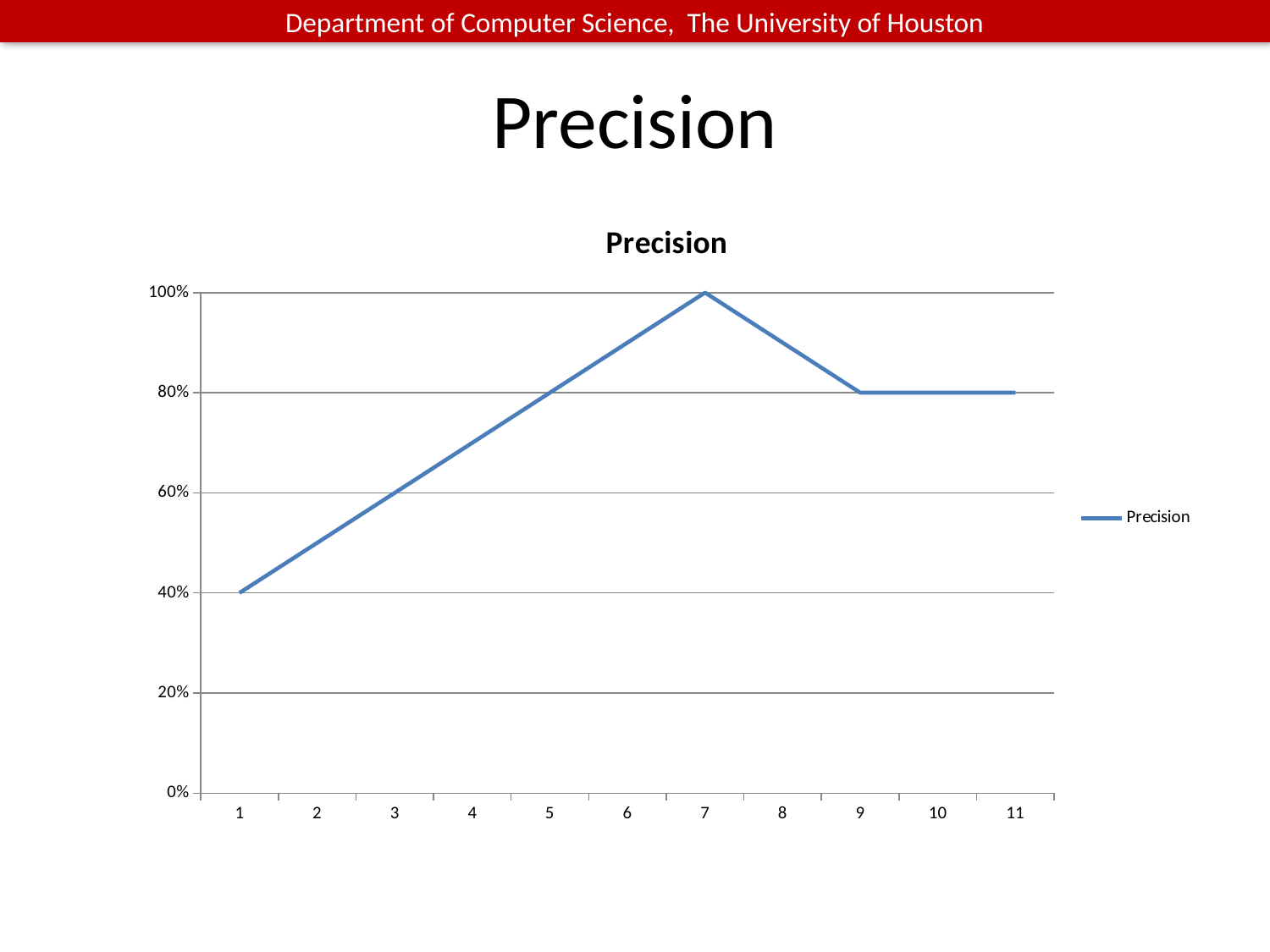
Does precision rise or fall from x = 1 to x = 7? rise At which x value is precision lowest? 1 What kind of chart is shown on the slide? line chart What is the precision value at x = 7? 100% What is the title of the chart? Precision What is the precision value at x = 1? 40% What is the precision value at x = 11? 80% How many data points are plotted along the x axis? 11 Is the precision value at x = 8 greater or less than 80%? greater How many series does the legend list? 1 At which x value is precision highest? 7 What is the difference between the precision at x = 7 and at x = 1? 60%